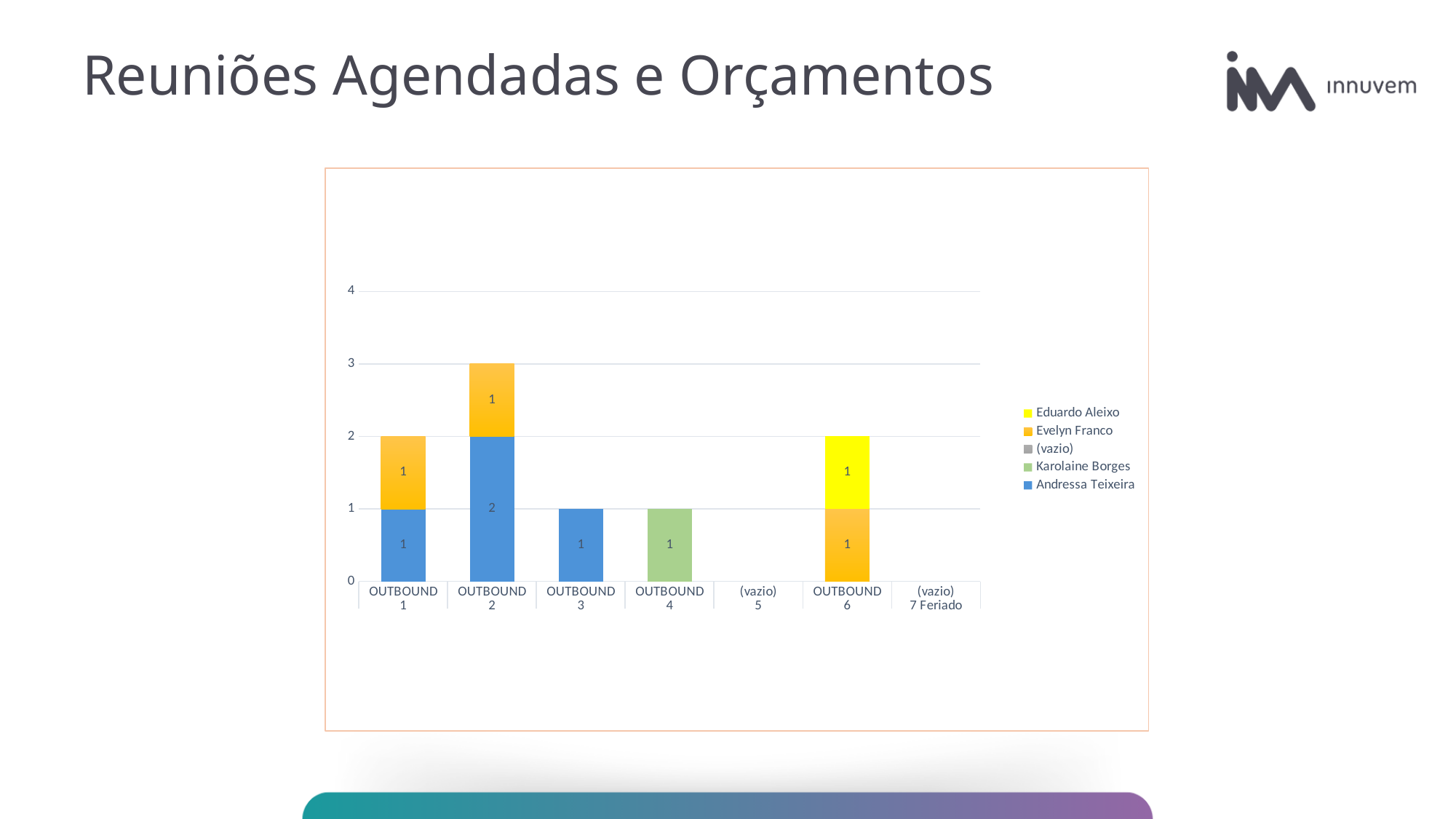
What is the value for Evelyn Franco in OUTBOUND 1? 1 What kind of chart is shown on the slide? Stacked bar chart What is the value for Karolaine Borges in OUTBOUND 4? 1 What is the value for Andressa Teixeira in OUTBOUND 2? 2 What is the value for Eduardo Aleixo in OUTBOUND 6? 1 Which category has the highest stacked bar total? OUTBOUND 2 What is the total of the stacked bar for OUTBOUND 6? 2 How many categories are shown on the x axis? 7 How many series does the legend list? 5 What is the total of the stacked bar for OUTBOUND 2? 3 Which series is shown in yellow in the legend? Eduardo Aleixo What is the difference between the Andressa Teixeira values for OUTBOUND 2 and OUTBOUND 3? 1